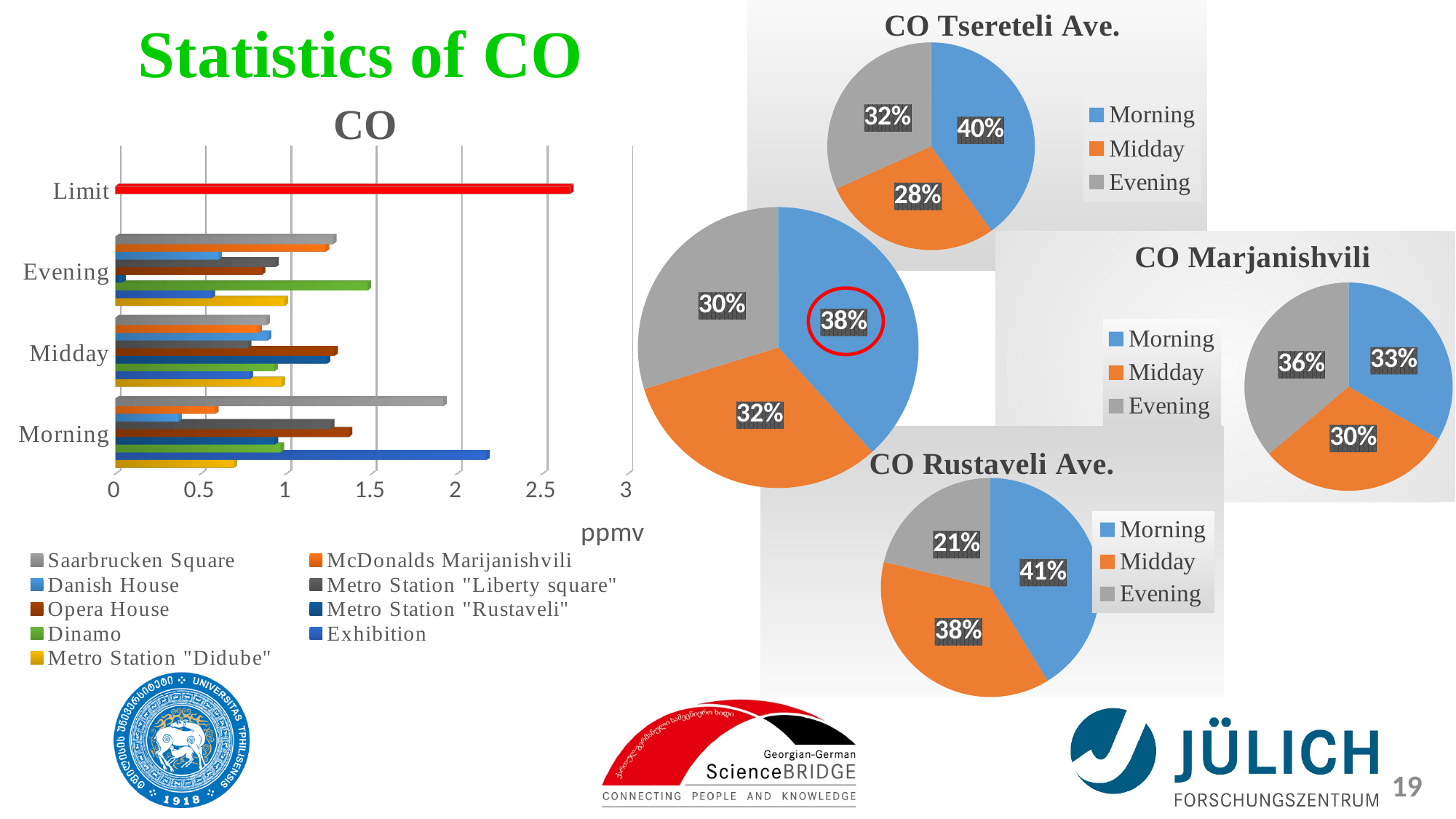
In the large untitled pie chart in the middle of the slide, what share is circled in red? 38% In the CO Rustaveli Ave. pie chart, which is larger, the Midday share or the Evening share? Midday In the CO Marjanishvili pie chart, which time of day has the largest share? Evening What kind of chart is the chart titled CO on the left of the slide? bar chart In the CO Tsereteli Ave. pie chart, which time of day has the smallest share? Midday In the CO bar chart, is the Morning value for Exhibition greater or less than 2 ppmv? greater How many entries does the legend of the CO Tsereteli Ave. pie chart list? 3 In the CO bar chart, is the value of the Limit bar greater or less than 2.5 ppmv? greater In the CO Tsereteli Ave. pie chart, what share does Morning have? 40% In the CO Marjanishvili pie chart, what share does Evening have? 36% In the CO Rustaveli Ave. pie chart, what is the difference between the Morning and Evening shares? 20% In the CO bar chart, how many series does the legend list? 9